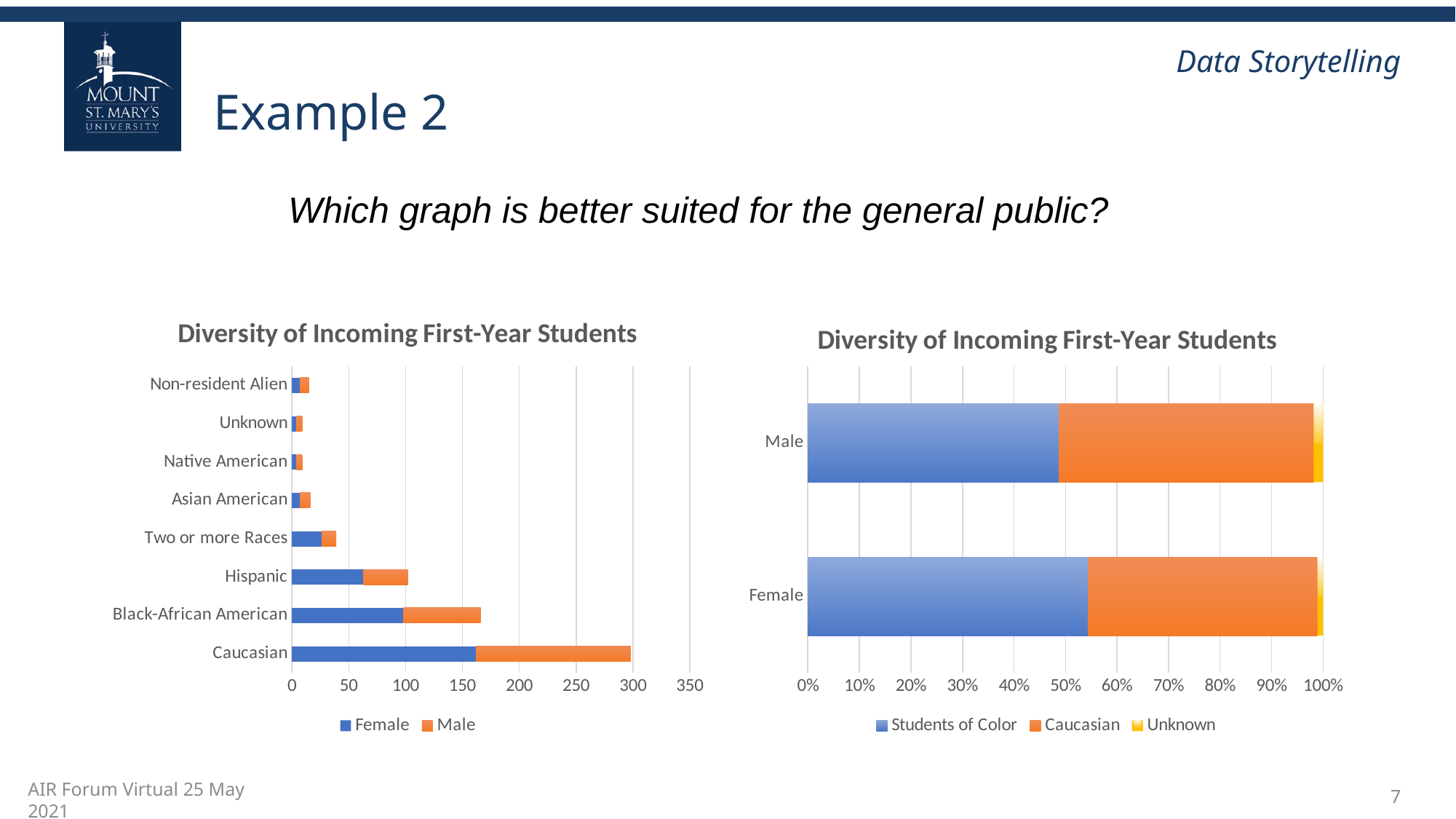
On the left chart, is the total value for Black-African American greater or less than 150? greater How many categories are shown on the left chart? 8 On the left chart, which has the larger total bar, Hispanic or Black-African American? Black-African American On the left chart, which category has the longest total bar? Caucasian On the right chart, is the Students of Color share for Female greater or less than 50%? greater On the left chart, is the total value for Caucasian greater or less than 250? greater What kind of chart is the left chart on the slide? Stacked bar chart How many series does the legend of the right chart list? 3 On the right chart, which series is shown in yellow? Unknown How many series does the legend of the left chart list? 2 How many categories are shown on the right chart? 2